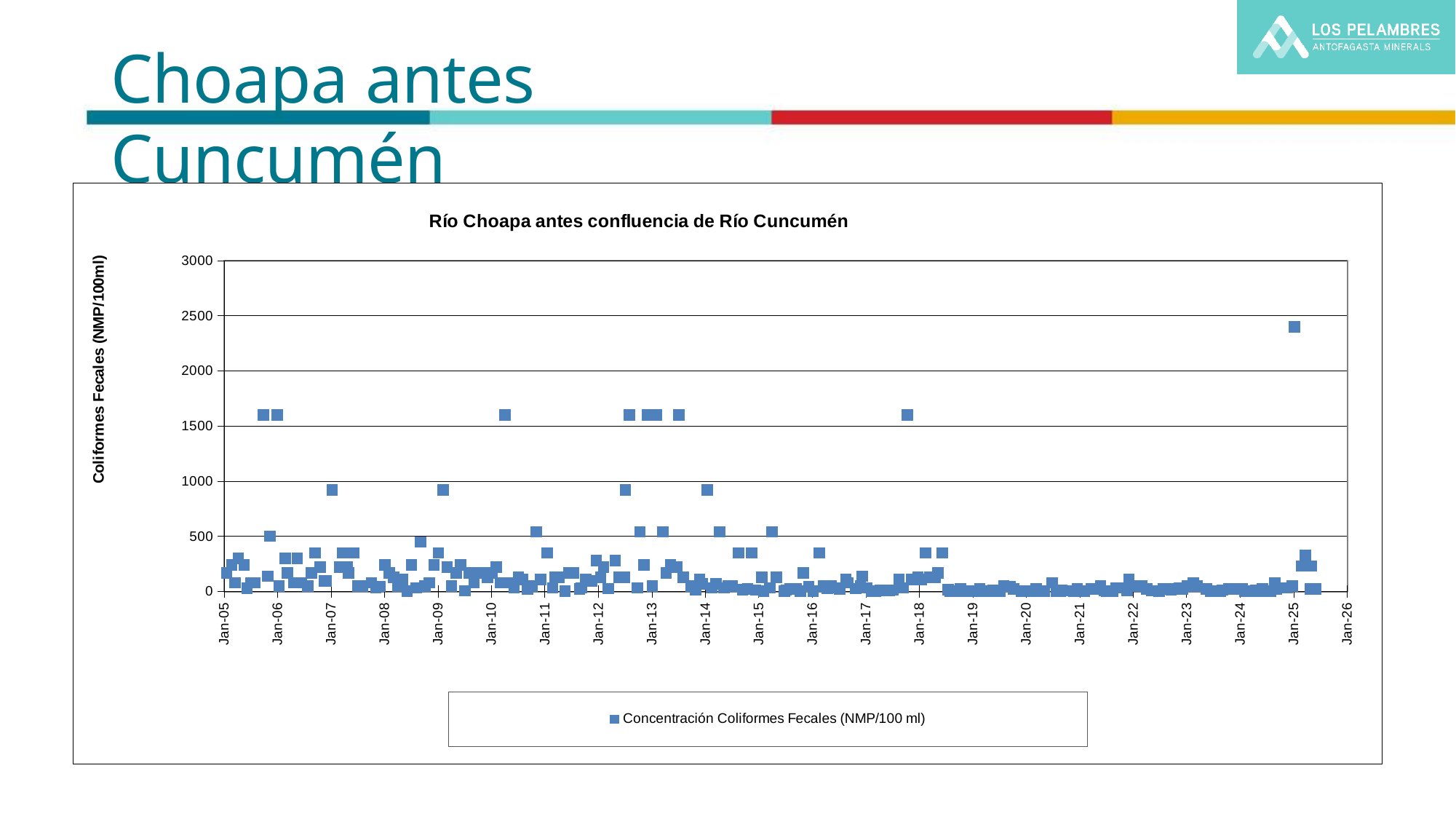
Are the plotted points near Jan-06 that form the upper cluster greater or less than 1500? greater What is the name of the series shown in the legend? Concentración Coliformes Fecales (NMP/100 ml) Is the highest plotted value, near Jan-25, greater or less than 2500? less What is the first year label shown on the horizontal axis? Jan-05 What kind of chart is shown on the slide? scatter chart What is the maximum value shown on the vertical axis? 3000 How many series does the chart legend list? 1 What is the label of the vertical axis? Coliformes Fecales (NMP/100ml) What is the title of the chart? Río Choapa antes confluencia de Río Cuncumén Are the plotted values between Jan-19 and Jan-24 greater or less than 500? less Around which year does the highest plotted point occur? Jan-25